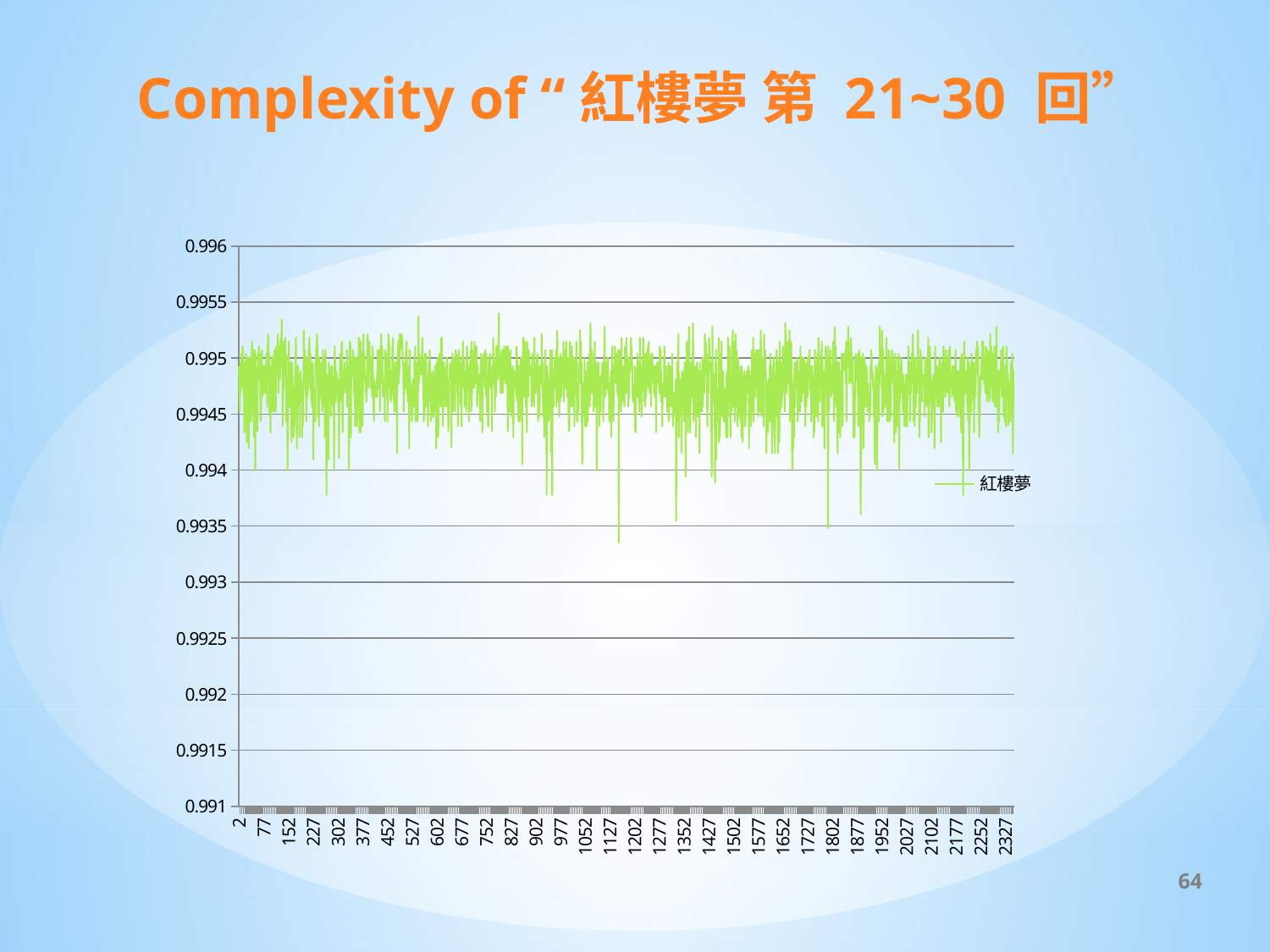
What is the first label on the x axis? 2 How many series does the legend list? 1 What is the maximum value shown on the y axis? 0.996 Is the highest value of the 紅樓夢 series greater or less than 0.9955? less What is the minimum value shown on the y axis? 0.991 What kind of chart is shown on the slide? line chart Is the value of the 紅樓夢 series at x = 2 greater or less than 0.994? greater Do the values of the 紅樓夢 series show a clear rising or falling trend along the x axis? No clear trend; the values fluctuate without rising or falling Is the lowest value of the 紅樓夢 series greater or less than 0.993? greater